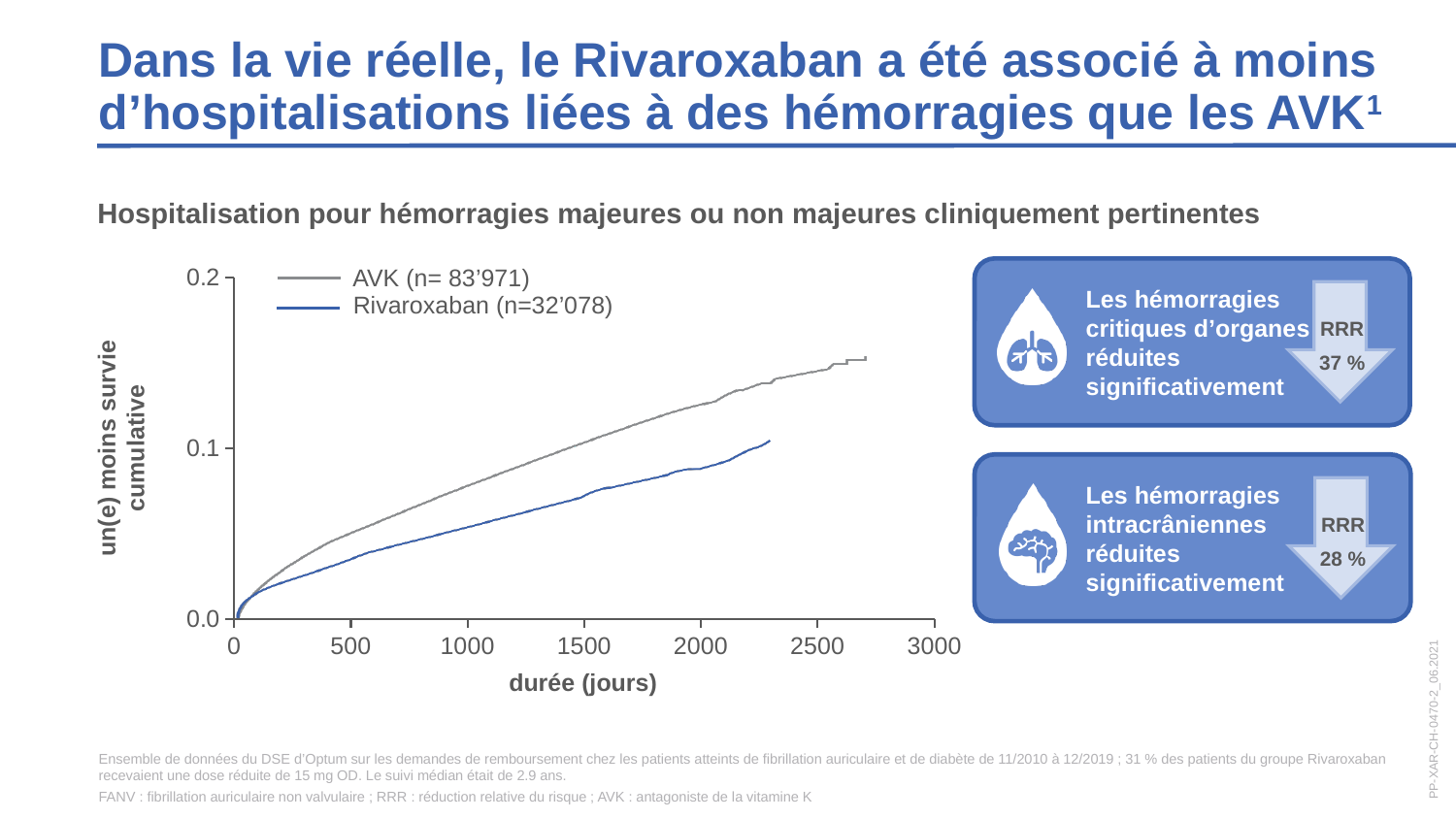
What kind of chart is shown on the slide? line chart At 2000 days, which series has the higher value, AVK or Rivaroxaban? AVK Is the value of the Rivaroxaban curve at 1000 days greater or less than 0.1? less What is the sample size shown in the legend for the AVK series? 83'971 How many series does the chart legend list? 2 What is the title of the x axis of the chart? durée (jours) Which two series are listed in the chart legend? AVK (n= 83'971) and Rivaroxaban (n=32'078) Is the value of the AVK curve at 1000 days greater or less than 0.1? less Is the value of the Rivaroxaban curve at 2000 days greater or less than 0.1? less Which series reaches the higher cumulative value by the end of its curve, AVK or Rivaroxaban? AVK Do the curves rise or fall as the duration in days increases? rise